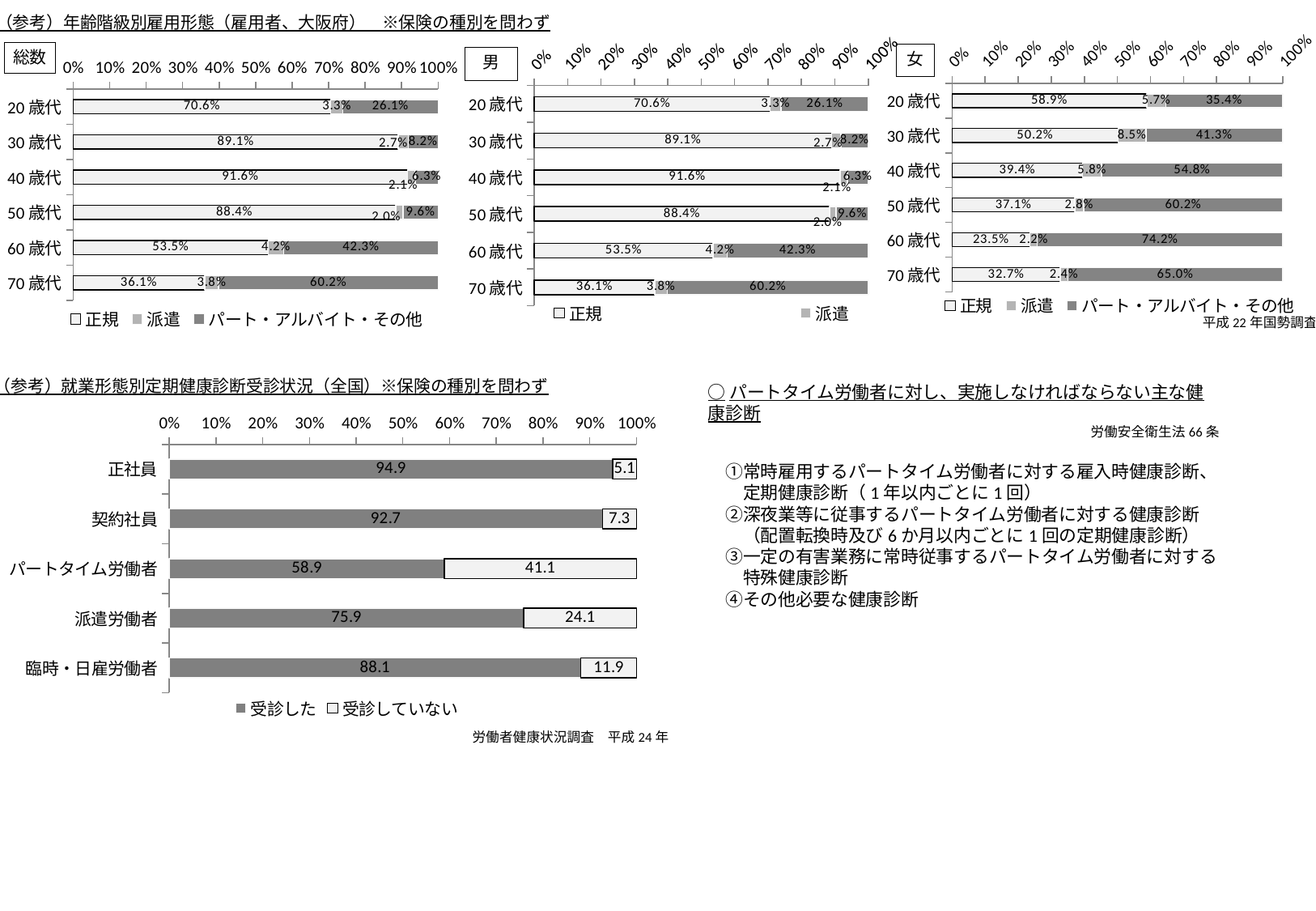
In the 総数 chart (top left), what is the 正規 value for 40歳代? 91.6% In the bottom-left chart (就業形態別定期健康診断受診状況), what is the difference between the 受診した values for 正社員 and 契約社員? 2.2 In the 男 chart (top middle), what is the 派遣 value for 60歳代? 4.2% What kind of chart is the bottom-left chart (就業形態別定期健康診断受診状況)? Stacked bar chart How many series does the legend of the 総数 chart (top left) list? 3 In the 女 chart (top right), which age group has the highest 正規 share? 20歳代 How many employment-type categories are shown in the bottom-left chart (就業形態別定期健康診断受診状況)? 5 In the 女 chart (top right), what is the パート・アルバイト・その他 value for 60歳代? 74.2% In the 総数 chart (top left), which age group has the lowest 正規 share? 70歳代 In the 女 chart (top right), which is larger, the 派遣 value for 30歳代 or for 20歳代? 30歳代 In the bottom-left chart (就業形態別定期健康診断受診状況), what is the 受診した value for パートタイム労働者? 58.9 In the bottom-left chart (就業形態別定期健康診断受診状況), which employment type has the highest 受診していない value? パートタイム労働者